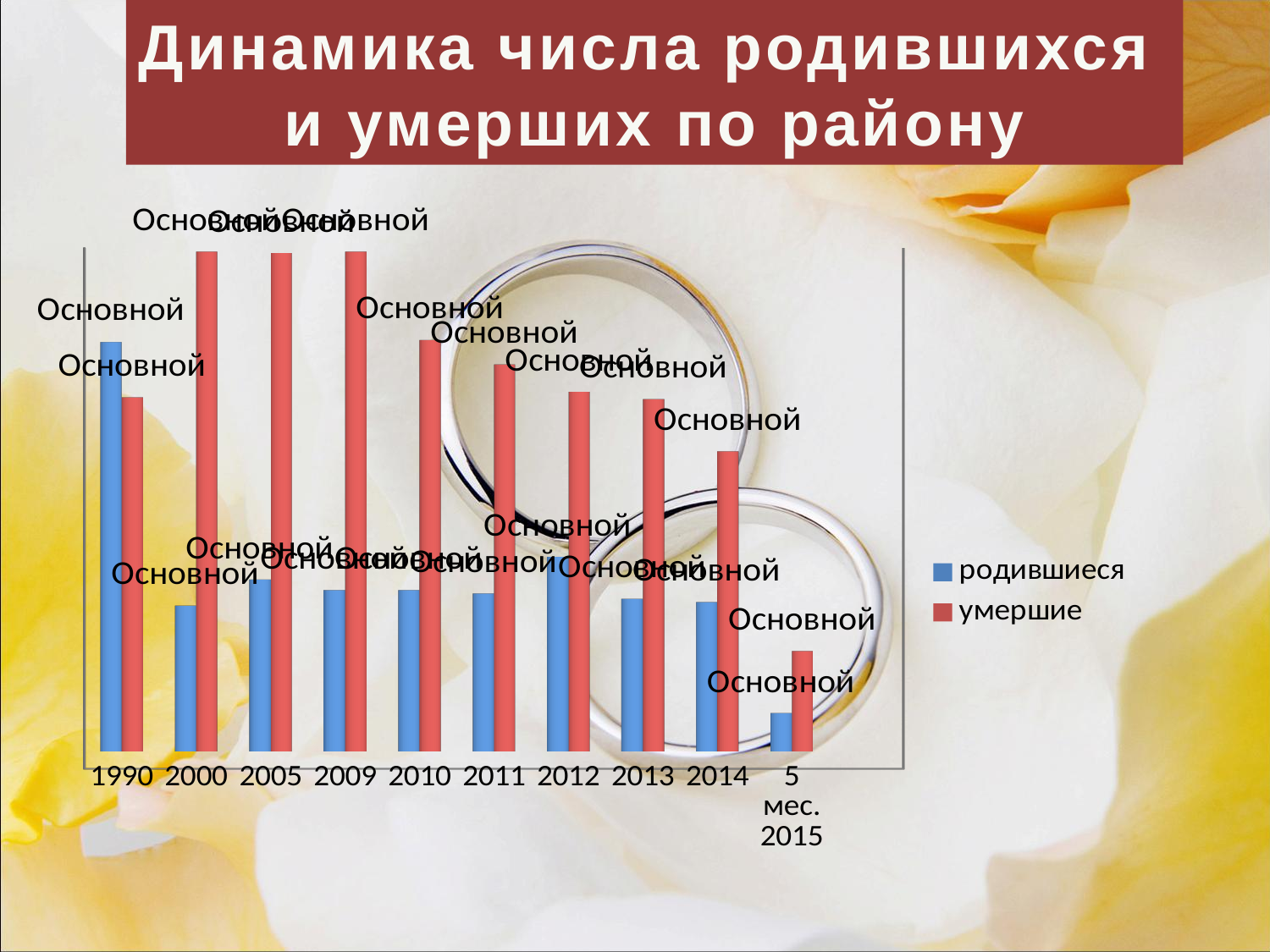
In 1990, which is larger: родившиеся or умершие? родившиеся How many series does the legend list? 2 Which category has the highest value for родившиеся? 1990 Which category has the lowest value for умершие? 5 мес. 2015 In 2014, which is larger: родившиеся or умершие? умершие How many categories are shown along the x axis? 10 In 2000, which is larger: родившиеся or умершие? умершие Which colour represents the умершие series? red What kind of chart is shown on the slide? bar chart Which category has the lowest value for родившиеся? 5 мес. 2015 What are the two series named in the legend? родившиеся and умершие Do the values for умершие rise or fall from 2009 to 2014? fall